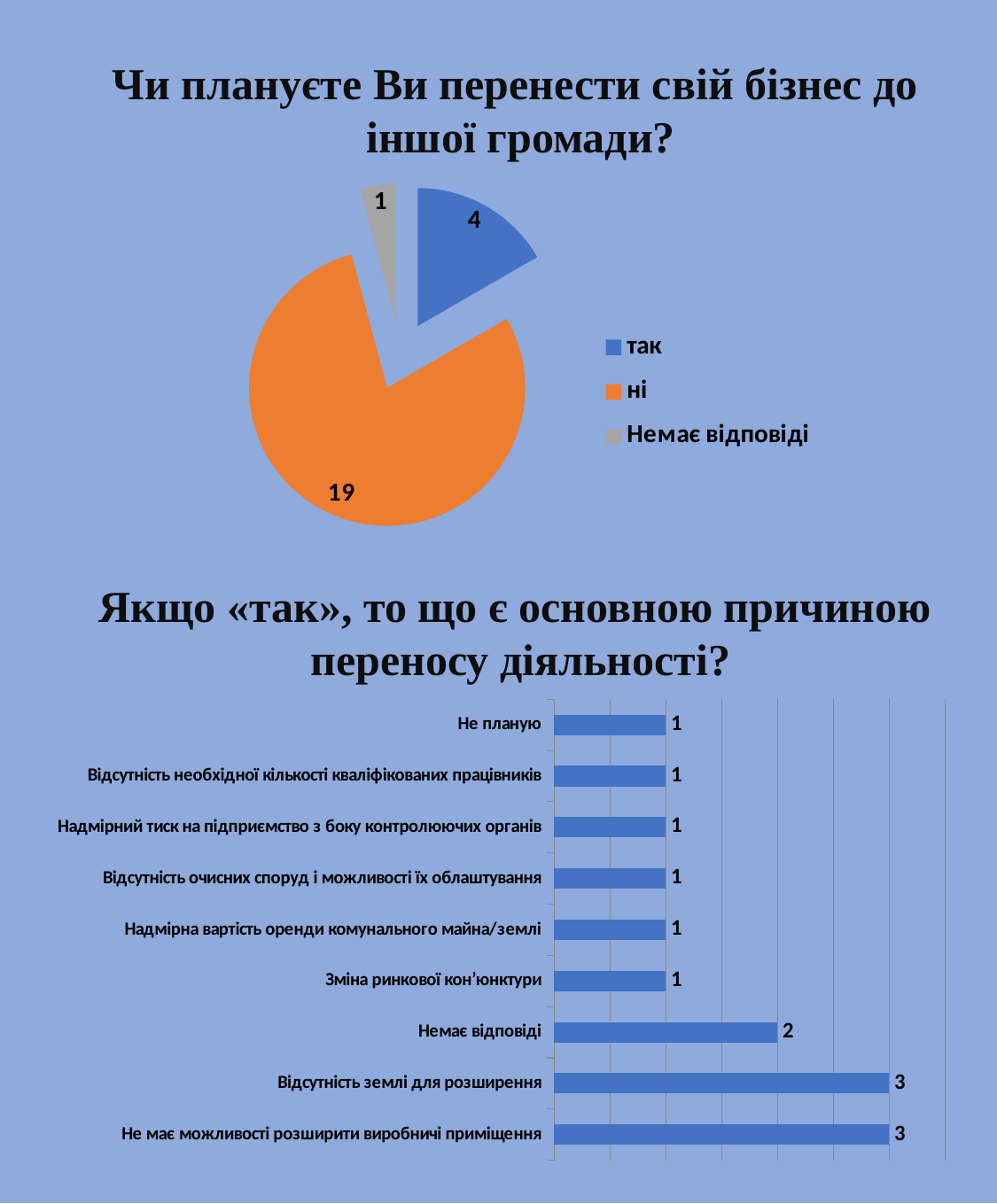
In the top pie chart, which answer has the smallest slice? Немає відповіді How many categories are shown in the bottom bar chart? 9 What type of chart is the bottom chart on the slide? bar chart In the bottom bar chart, what is the value for "Відсутність землі для розширення"? 3 In the top pie chart, which answer has the largest slice? ні In the top pie chart, what is the difference between the number of "ні" and "так" answers? 15 How many entries does the legend of the top pie chart list? 3 In the bottom bar chart, which is larger: the value for "Немає відповіді" or the value for "Зміна ринкової кон’юнктури"? Немає відповіді In the top pie chart, how many respondents answered "ні"? 19 In the top pie chart, how many respondents answered "так"? 4 In the top pie chart, what is the value for "Немає відповіді"? 1 In the bottom bar chart, what is the value for "Немає відповіді"? 2